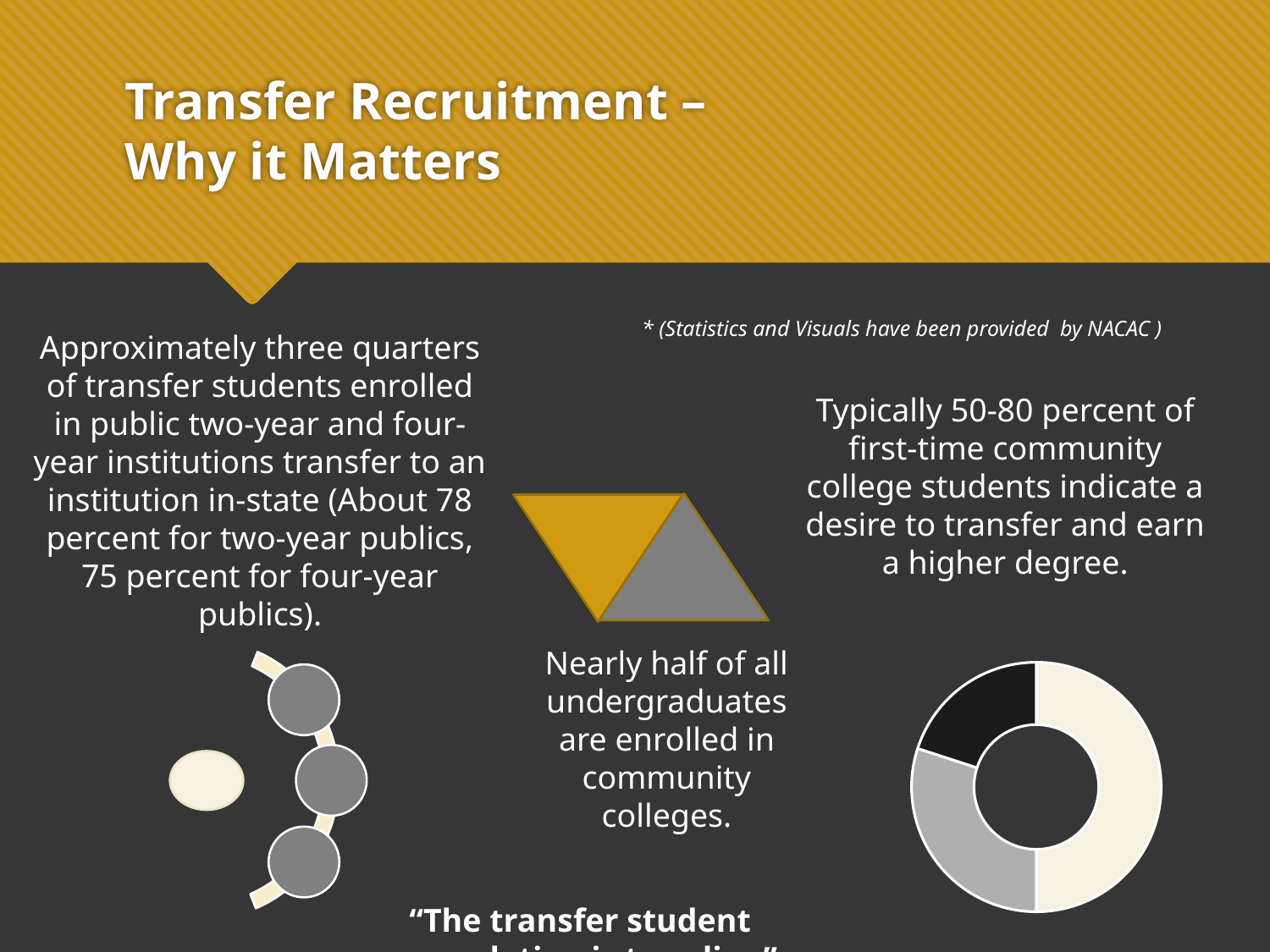
What kind of chart is shown at the bottom right of the slide? Donut chart What three colours are used for the slices of the donut chart at the bottom right? Cream, gray and black Does the donut chart at the bottom right of the slide show a legend? No In the donut chart at the bottom right, which colour slice is the largest? Cream In the donut chart at the bottom right, is the cream slice or the black slice larger? Cream How many slices does the donut chart at the bottom right of the slide have? 3 In the donut chart at the bottom right, is the gray slice or the black slice larger? Gray In the donut chart at the bottom right, which colour slice is the smallest? Black